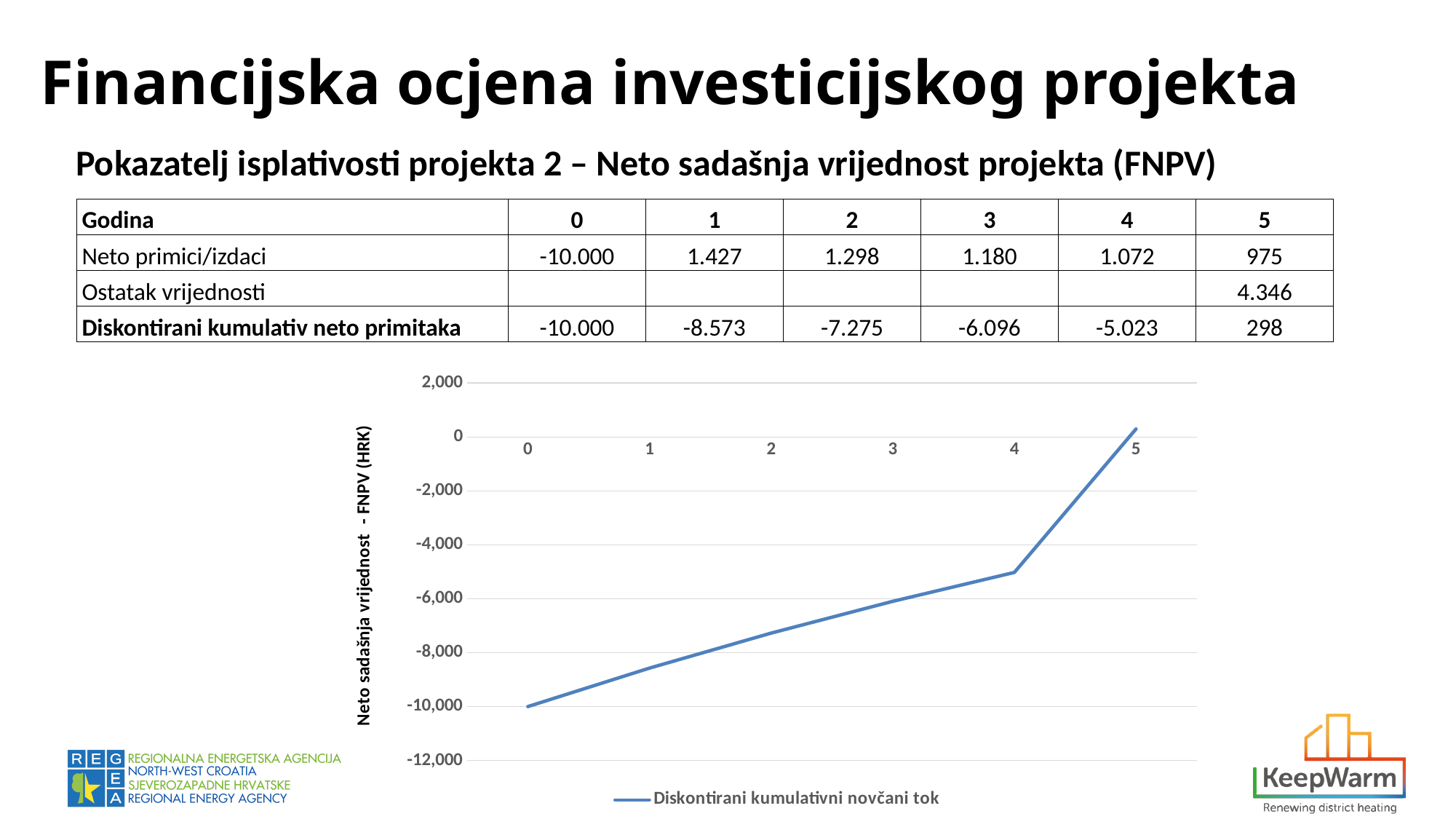
How many series does the chart legend list? 1 What is the legend entry of the series plotted in the chart? Diskontirani kumulativni novčani tok What kind of chart is shown on the slide? line chart Which year has the highest value in the chart? 5 Is the value for year 4 greater or less than -4,000? less What value does the line show at year 0? -10,000 Which year has the lowest value in the chart? 0 Is the value for year 5 greater or less than 0? greater What is the title of the vertical axis of the chart? Neto sadašnja vrijednost - FNPV (HRK) How many data points are plotted on the line chart? 6 Do the values in the chart rise or fall from year 0 to year 5? rise Is the value for year 2 greater or less than -8,000? greater